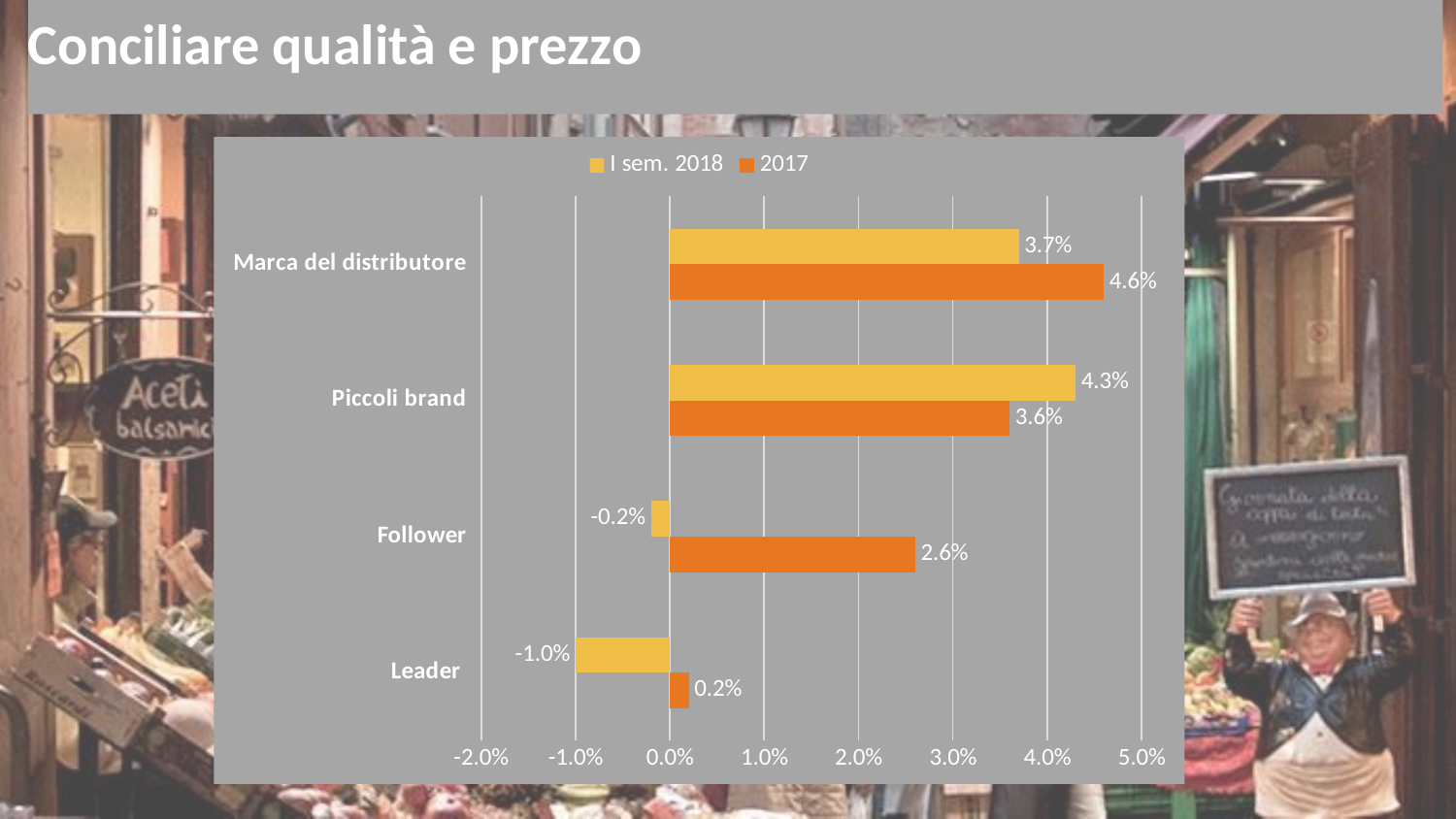
What is the difference between the 2017 and I sem. 2018 values for Marca del distributore? 0.9% How many series does the legend list? 2 Which series is shown in orange in the legend? 2017 How many categories are shown on the chart? 4 Which category has the highest value in the 2017 series? Marca del distributore What is the value for Leader in the 2017 series? 0.2% Which is larger for Piccoli brand: the I sem. 2018 value or the 2017 value? I sem. 2018 What kind of chart is shown on the slide? Bar chart What is the value for Marca del distributore in the 2017 series? 4.6% Which category has the lowest value in the I sem. 2018 series? Leader What is the value for Follower in the I sem. 2018 series? -0.2% What is the value for Piccoli brand in the I sem. 2018 series? 4.3%